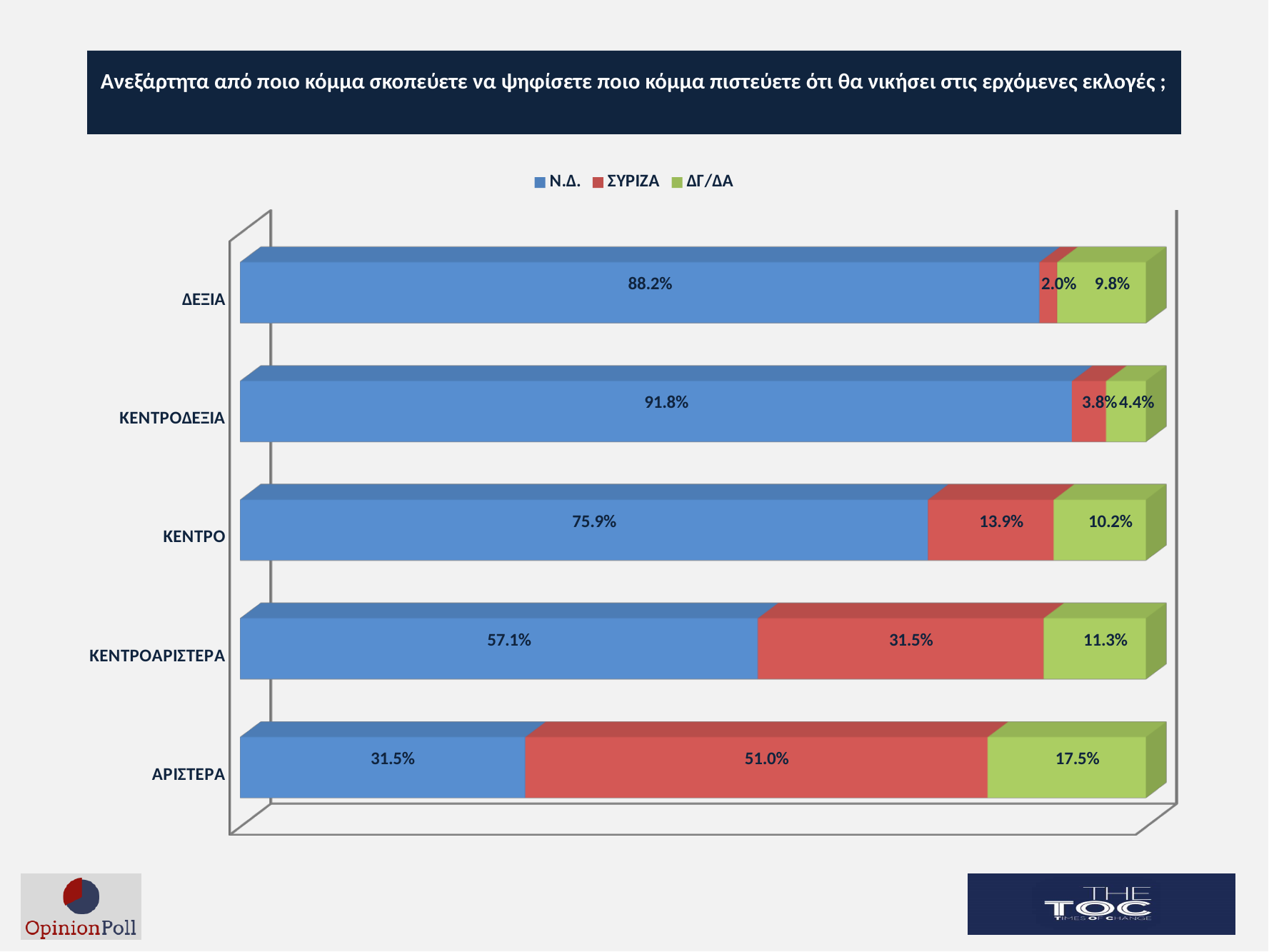
How many categories are shown on the chart? 5 Which category has the highest Ν.Δ. value? ΚΕΝΤΡΟΔΕΞΙΑ What is the Ν.Δ. value for ΚΕΝΤΡΟ? 75.9% What kind of chart is shown on the slide? Stacked bar chart What is the difference between the ΣΥΡΙΖΑ values for ΑΡΙΣΤΕΡΑ and ΚΕΝΤΡΟΑΡΙΣΤΕΡΑ? 19.5 percentage points What is the ΔΓ/ΔΑ value for ΚΕΝΤΡΟΔΕΞΙΑ? 4.4% What is the ΣΥΡΙΖΑ value for ΑΡΙΣΤΕΡΑ? 51.0% What is the total of the stacked bar for ΚΕΝΤΡΟΑΡΙΣΤΕΡΑ? 99.9% How many series does the legend list? 3 Which series is shown in green in the legend? ΔΓ/ΔΑ Which is larger: the ΔΓ/ΔΑ value for ΚΕΝΤΡΟ or for ΔΕΞΙΑ? ΚΕΝΤΡΟ Which category has the lowest ΣΥΡΙΖΑ value? ΔΕΞΙΑ